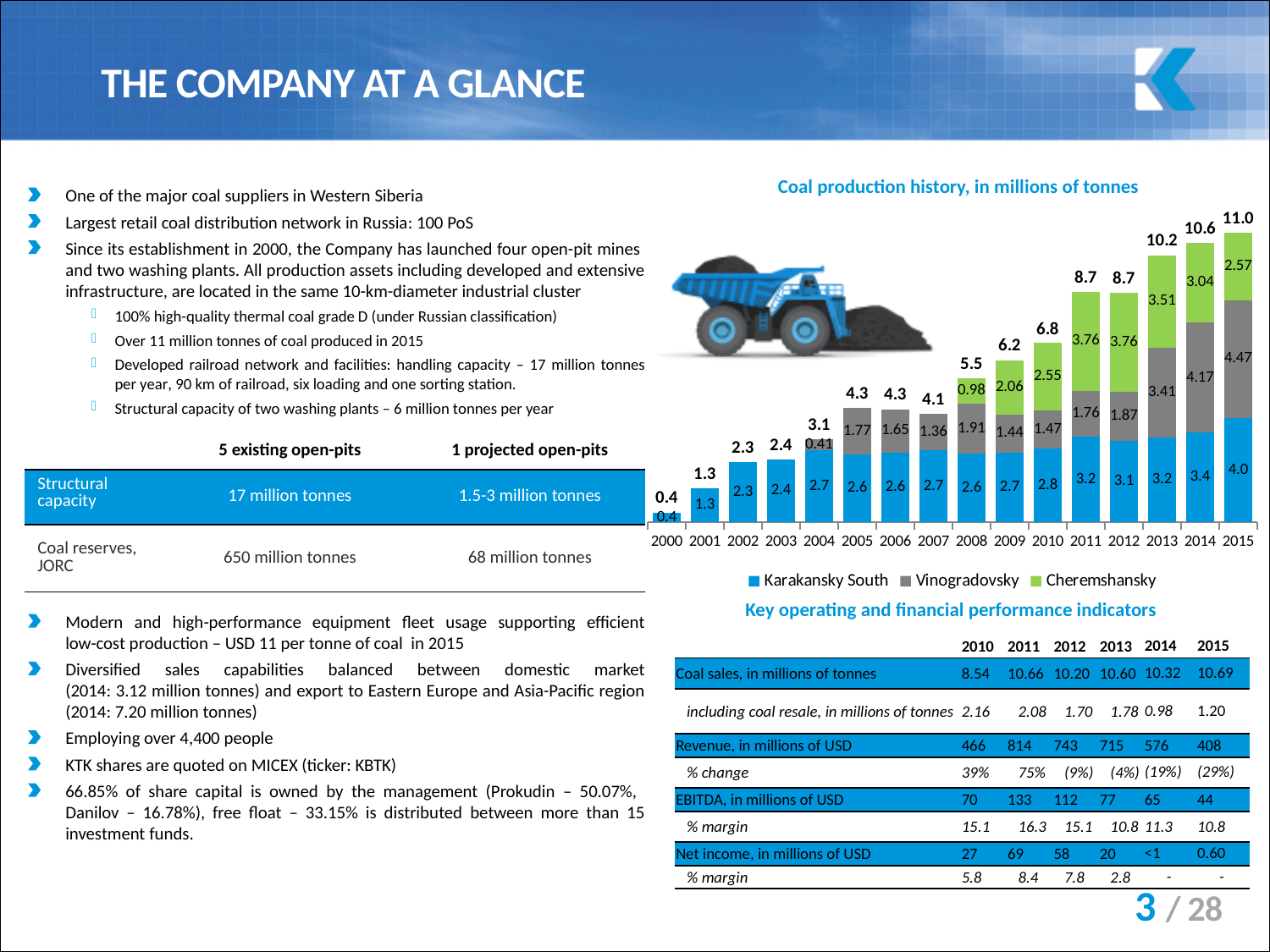
What was the Vinogradovsky production in 2014 in the coal production history chart? 4.17 What was the Cheremshansky production in 2011 in the coal production history chart? 3.76 How many series does the legend of the coal production history chart list? 3 What was the total coal production in 2015 according to the chart? 11.0 In 2015, which was larger: Vinogradovsky or Cheremshansky production? Vinogradovsky Which year has the lowest total coal production in the chart? 2000 How many years are shown on the x axis of the coal production history chart? 16 What was the Karakansky South production in 2015 in the coal production history chart? 4.0 What type of chart is used to show the coal production history? Stacked bar chart By how much did total coal production increase from 2010 to 2011 according to the chart? 1.9 Which year has the highest total coal production in the chart? 2015 What is the overall trend of total coal production from 2000 to 2015 in the chart? Rising